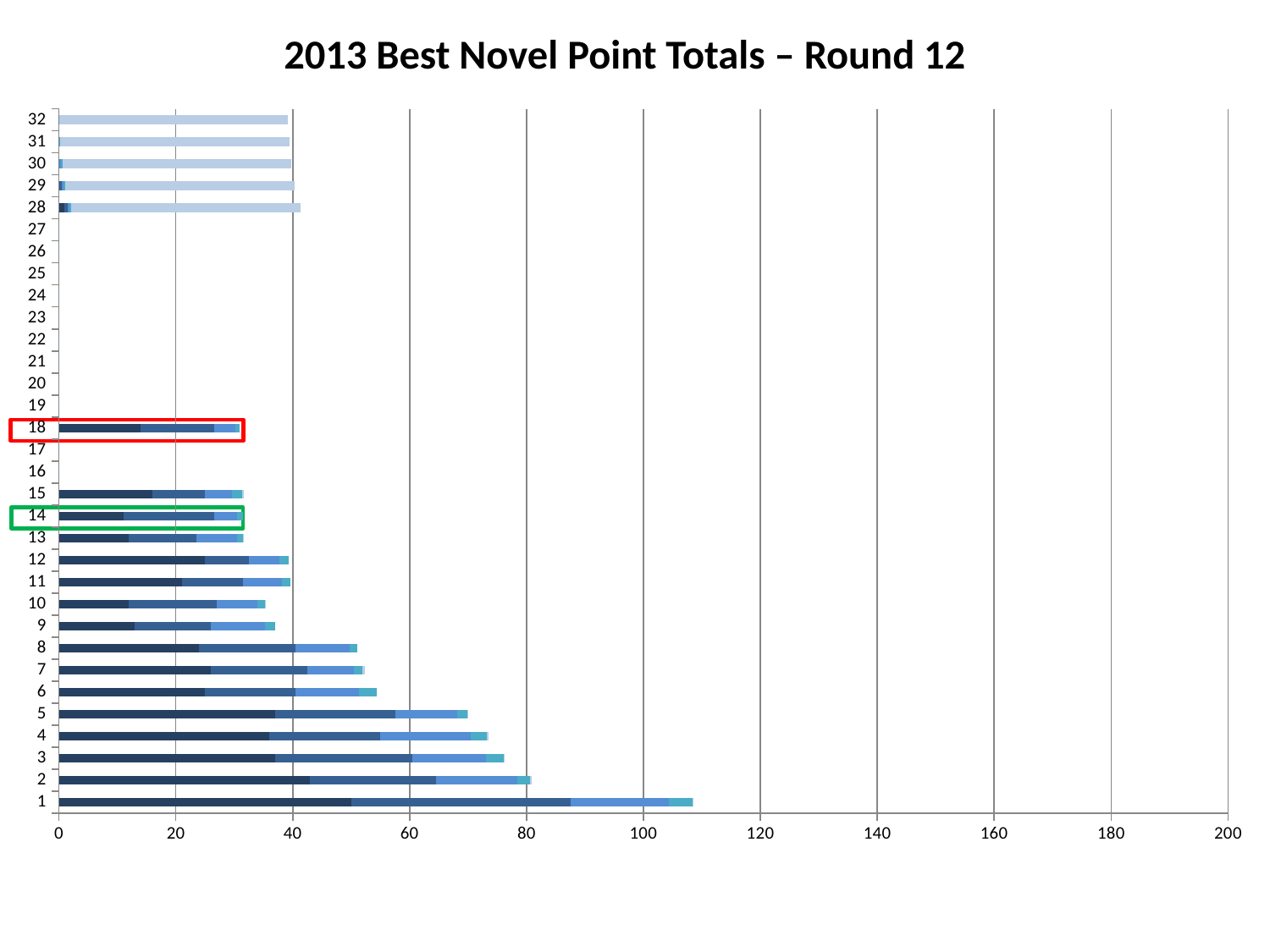
Which has the larger total, category 1 or category 2? 1 Which category is outlined with a red box on the chart? 18 Which category has the highest total on the chart? 1 What kind of chart is shown on the slide? Bar chart How many categories are listed on the vertical axis of the chart? 32 Is the total for category 6 greater or less than 40? greater Is the total for category 2 greater or less than 100? less Which has the larger total, category 5 or category 8? 5 What is the title of the chart? 2013 Best Novel Point Totals – Round 12 Is the total for category 10 greater or less than 40? less